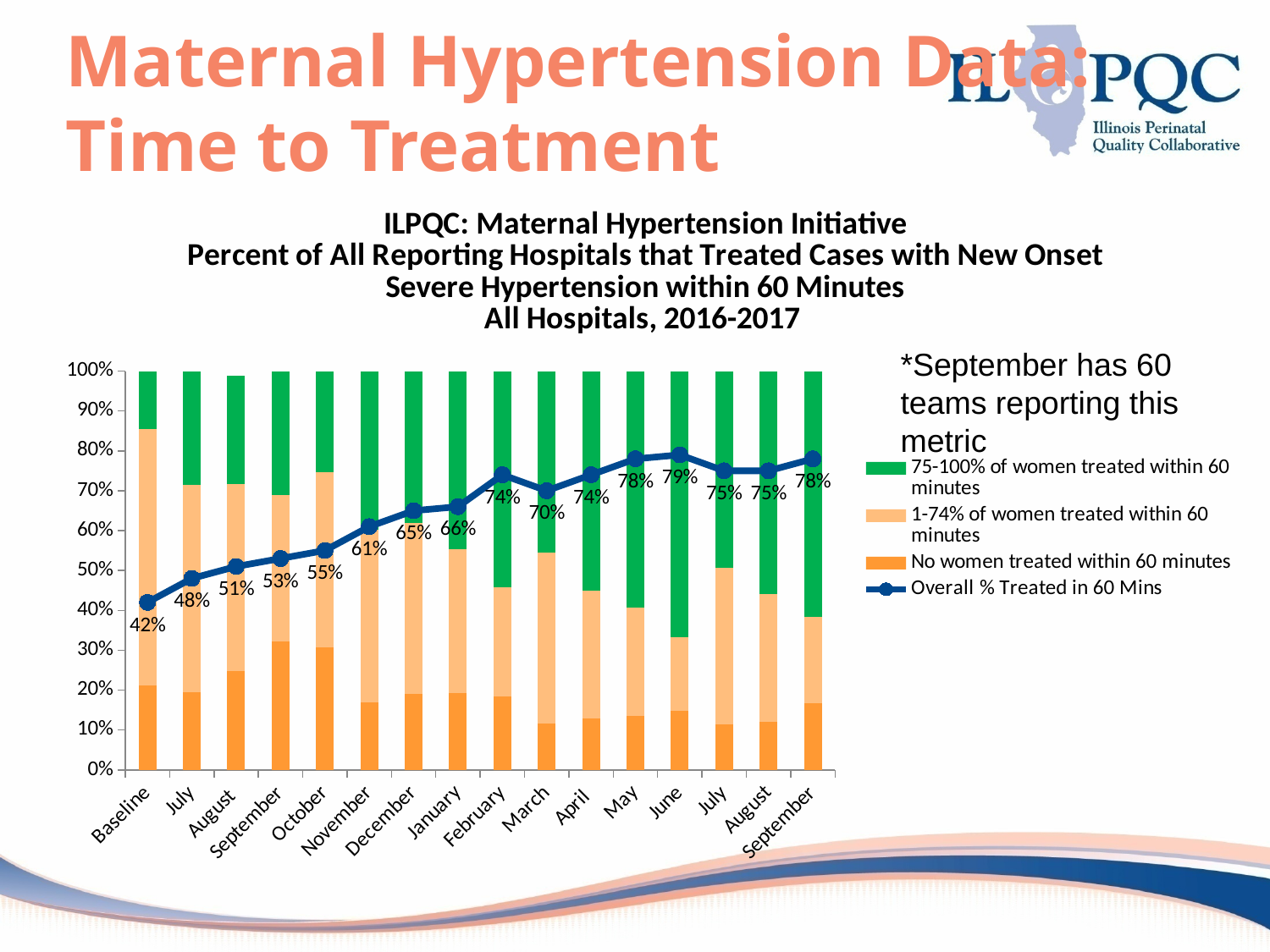
Which period has the lowest Overall % Treated in 60 Mins? Baseline What is the Overall % Treated in 60 Mins value for November? 61% How many entries does the chart legend list? 4 Is the 'No women treated within 60 minutes' share for October greater or less than 20%? greater By how many percentage points does the Overall % Treated in 60 Mins for June exceed the Baseline value? 37 percentage points What is the Overall % Treated in 60 Mins value for June? 79% Which has a higher Overall % Treated in 60 Mins, February or March? February What kind of chart is shown on the slide? Stacked bar chart with a line overlay How many periods are shown along the x axis of the chart? 16 Which period has the highest Overall % Treated in 60 Mins? June Does the Overall % Treated in 60 Mins line generally rise or fall from Baseline to June? Rise What is the Overall % Treated in 60 Mins value at Baseline? 42%